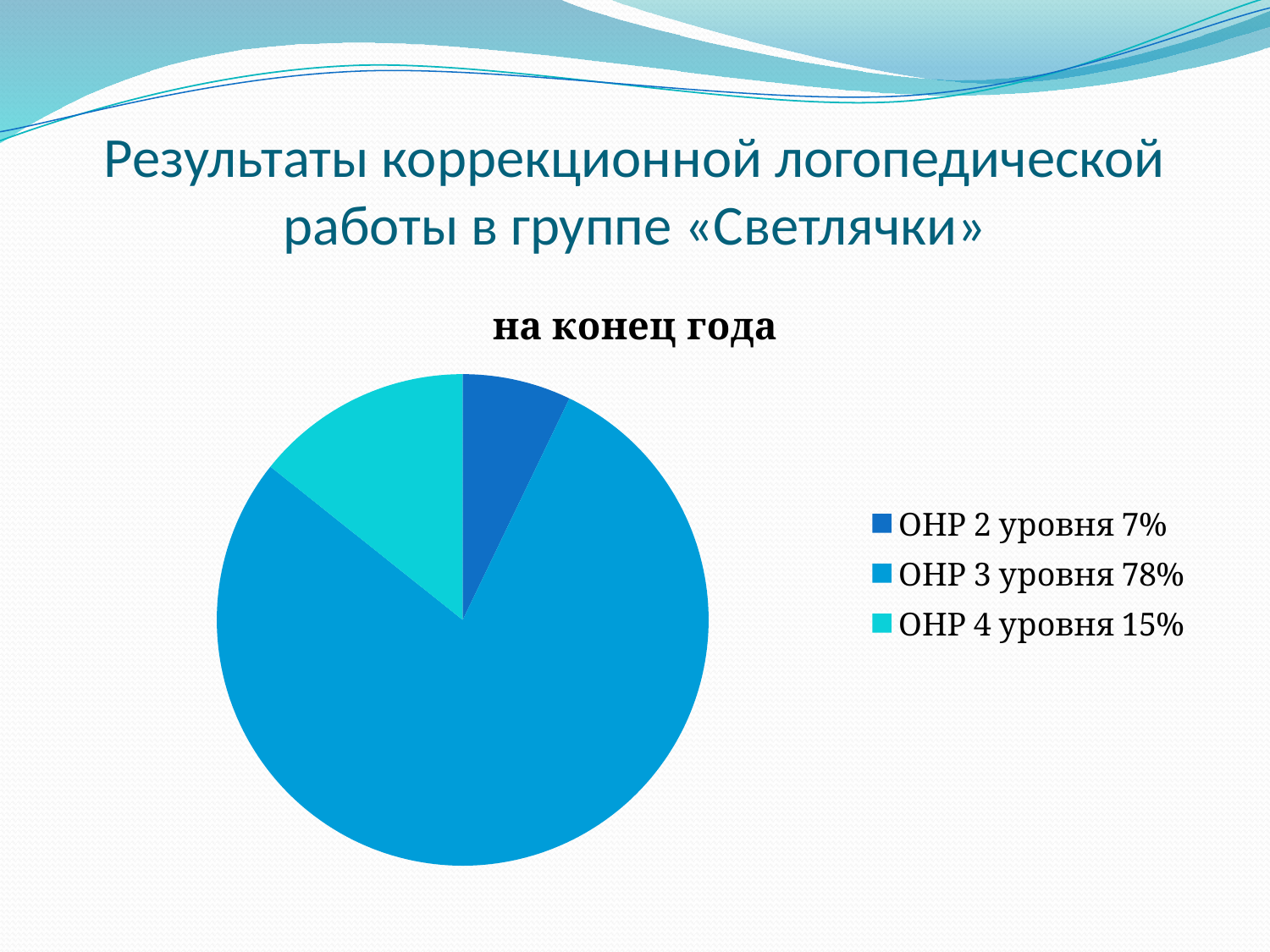
What kind of chart is shown on the slide? pie chart Which category has the smallest slice of the pie? ОНР 2 уровня How many slices does the pie chart have? 3 What is the difference in percentage points between ОНР 3 уровня and ОНР 4 уровня? 63 What share of the pie is ОНР 3 уровня? 78% What share of the pie is ОНР 4 уровня? 15% Which category has the largest slice of the pie? ОНР 3 уровня Which is larger, the share for ОНР 4 уровня or the share for ОНР 2 уровня? ОНР 4 уровня What is the title of the chart? на конец года What is the difference in percentage points between ОНР 4 уровня and ОНР 2 уровня? 8 How many entries does the legend list? 3 What share of the pie is ОНР 2 уровня? 7%